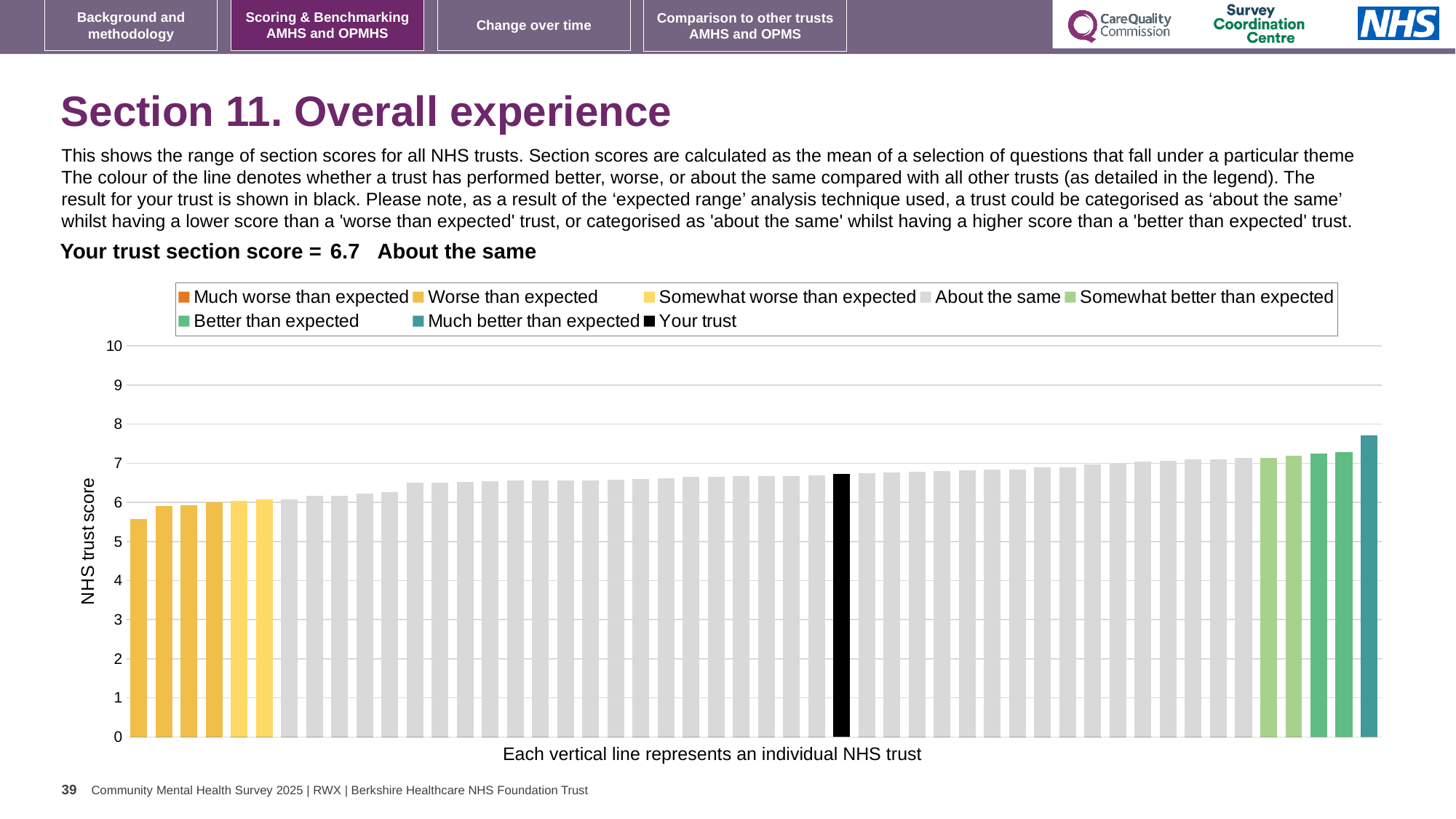
Is the value of the rightmost (highest) bar greater or less than 7? greater Is the value of the black 'Your trust' bar greater or less than 5? greater What kind of chart is shown on the slide? bar chart Is the value of the leftmost (lowest) bar greater or less than 6? less What is the label on the vertical axis of the chart? NHS trust score How many entries does the chart legend list? 8 What is the section score for your trust shown on the slide? 6.7 Which category is your trust placed in according to the slide? About the same What colour is the bar representing your trust? black How many bars are coloured as 'Much better than expected'? 1 Do the bar values rise or fall from left to right across the chart? rise